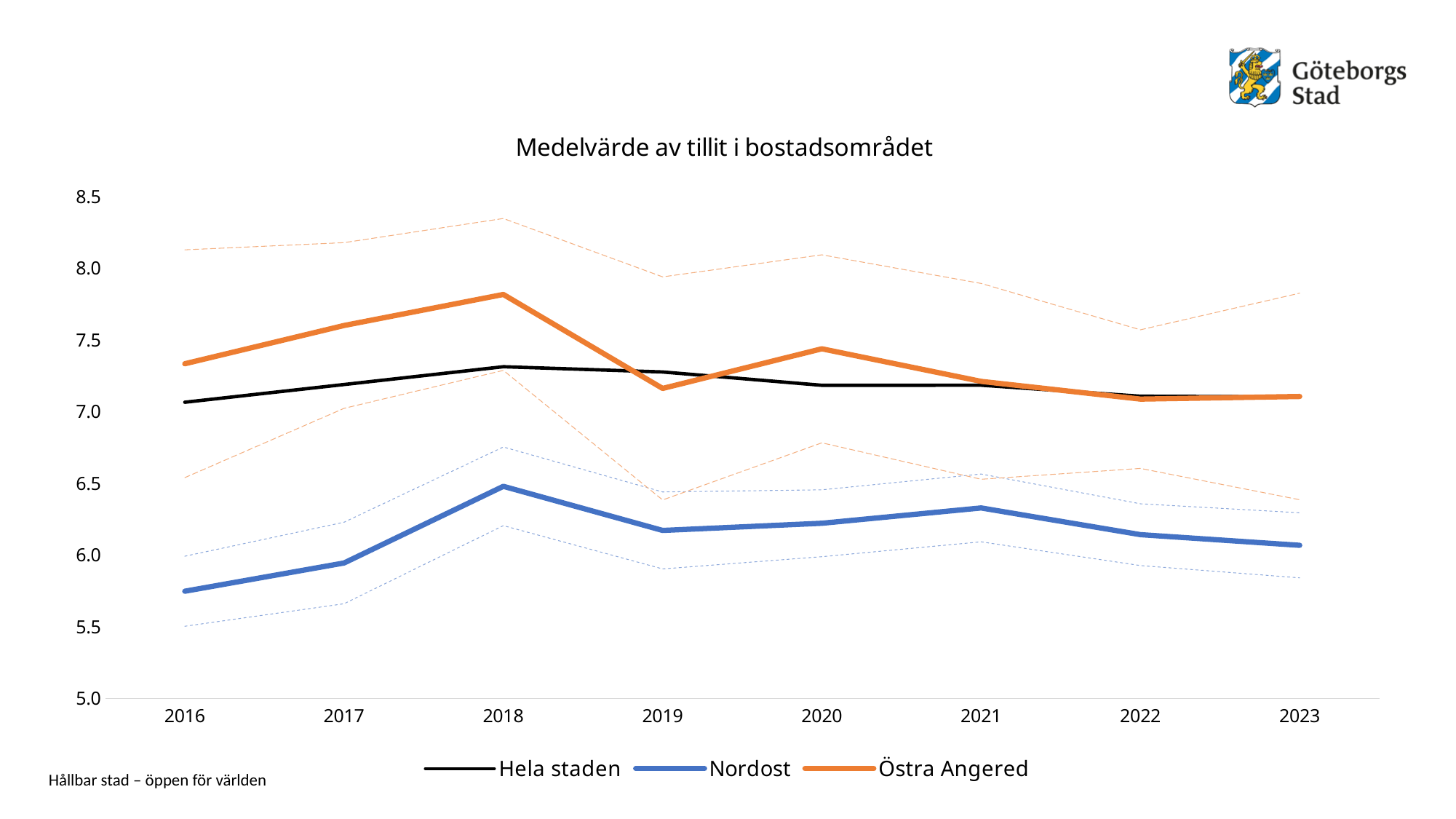
Which series is drawn in orange? Östra Angered Does the Nordost line rise or fall from 2018 to 2023? fall In 2016, which is larger: the value for Östra Angered or the value for Nordost? Östra Angered In which year does the Östra Angered line reach its highest value? 2018 How many series does the legend list? 3 What is the title of the chart? Medelvärde av tillit i bostadsområdet How many years are shown on the x axis? 8 What kind of chart is shown on the slide? line chart In which year does the Nordost line have its lowest value? 2016 Is the value for Östra Angered in 2018 greater or less than 7.5? greater Is the value for Nordost in 2016 greater or less than 6.0? less In which year does the Nordost line reach its highest value? 2018